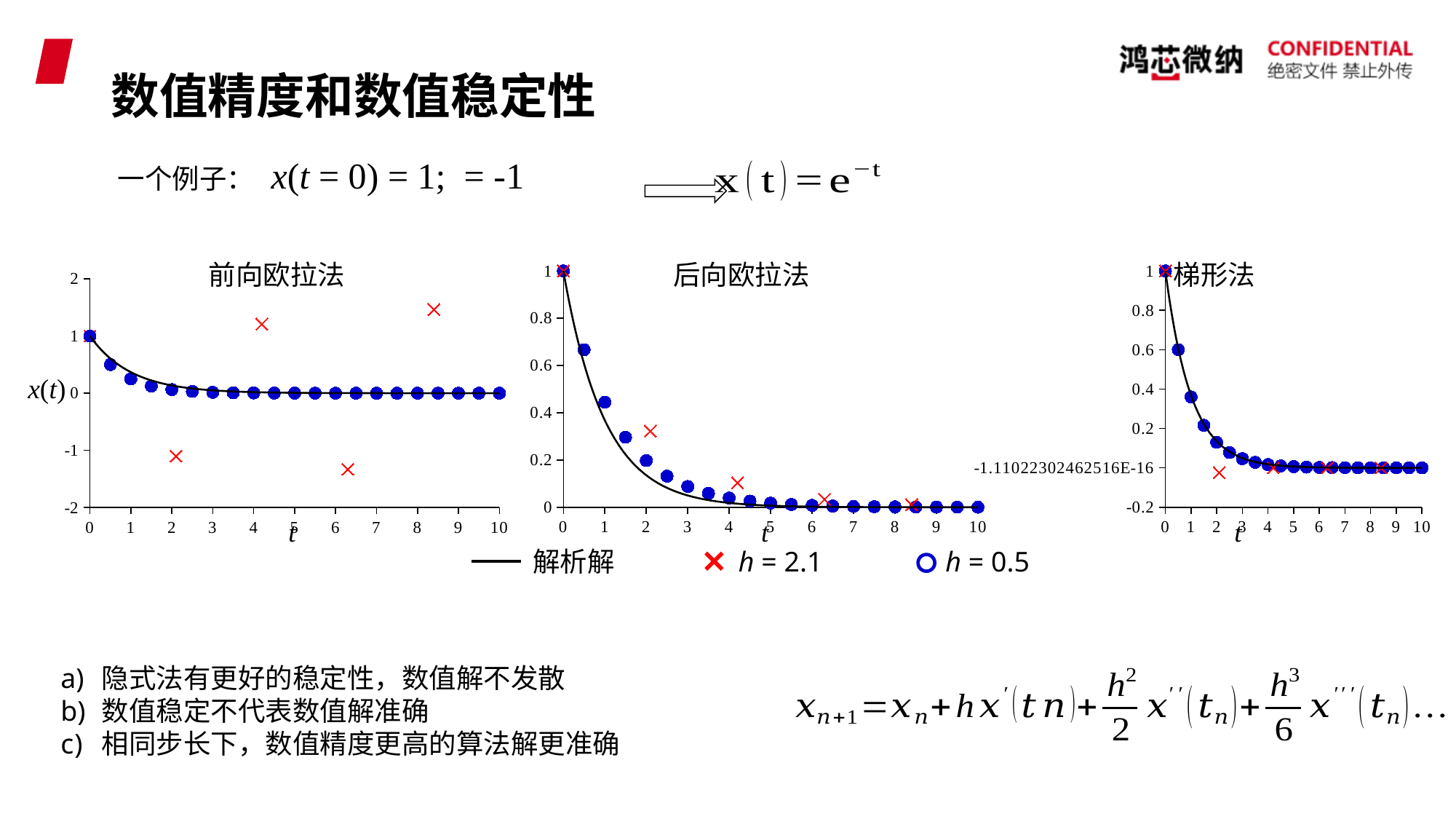
What is the highest tick value on the y axis of the 前向欧拉法 chart? 2 How many series does the shared legend below the charts list? 3 What is the title of the leftmost chart? 前向欧拉法 In the 前向欧拉法 chart, is the h = 2.1 value near t = 6.3 greater or less than -1? less In the 后向欧拉法 chart, do the h = 0.5 values rise or fall as t increases? fall In the 后向欧拉法 chart, what is the value of the plotted points at t = 0? 1 In the 后向欧拉法 chart, is the h = 2.1 value near t = 2.1 greater or less than 0.4? less Which series in the legend is drawn with red crosses? h = 2.1 In the 梯形法 chart, do the h = 0.5 values rise or fall as t increases? fall In the 前向欧拉法 chart, which h = 2.1 point is higher: the one near t = 4.2 or the one near t = 8.4? the one near t = 8.4 In the 前向欧拉法 chart, is the h = 2.1 value near t = 8.4 greater or less than 1? greater